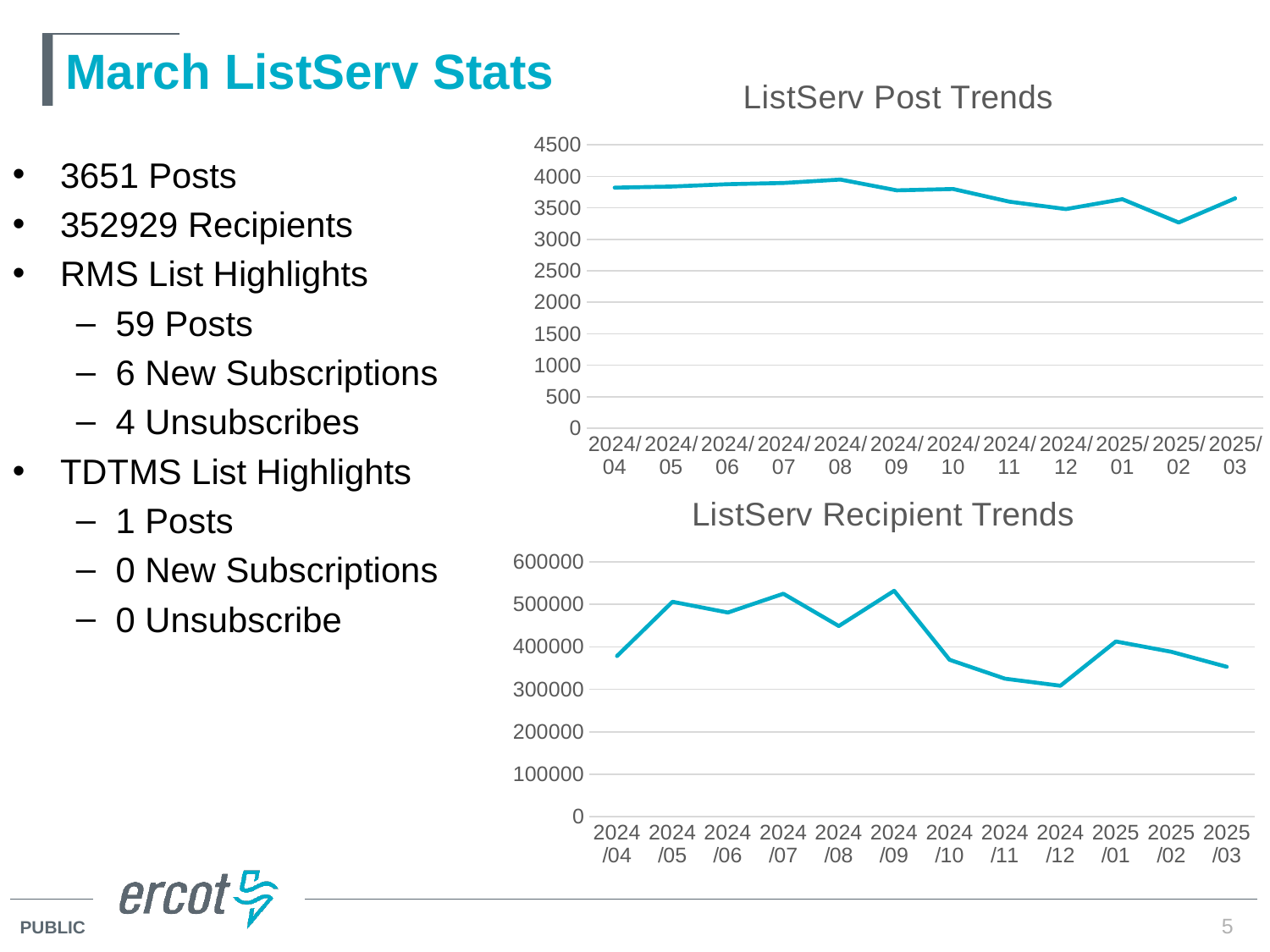
On the 'ListServ Recipient Trends' chart, do the values rise or fall from 2024/09 to 2024/12? fall What kind of chart is the 'ListServ Recipient Trends' chart? line chart On the 'ListServ Recipient Trends' chart, is the value for 2024/09 greater or less than 500000? greater How many months are plotted on the 'ListServ Recipient Trends' chart? 12 On the 'ListServ Recipient Trends' chart, is the value for 2024/12 greater or less than 400000? less On the 'ListServ Post Trends' chart, is the value for 2024/08 greater or less than 3500? greater On the 'ListServ Recipient Trends' chart, which month has the lowest number of recipients? 2024/12 What kind of chart is the 'ListServ Post Trends' chart? line chart On the 'ListServ Post Trends' chart, which month has the lowest number of posts? 2025/02 How many months are plotted on the 'ListServ Post Trends' chart? 12 On the 'ListServ Recipient Trends' chart, which month has more recipients, 2024/05 or 2024/12? 2024/05